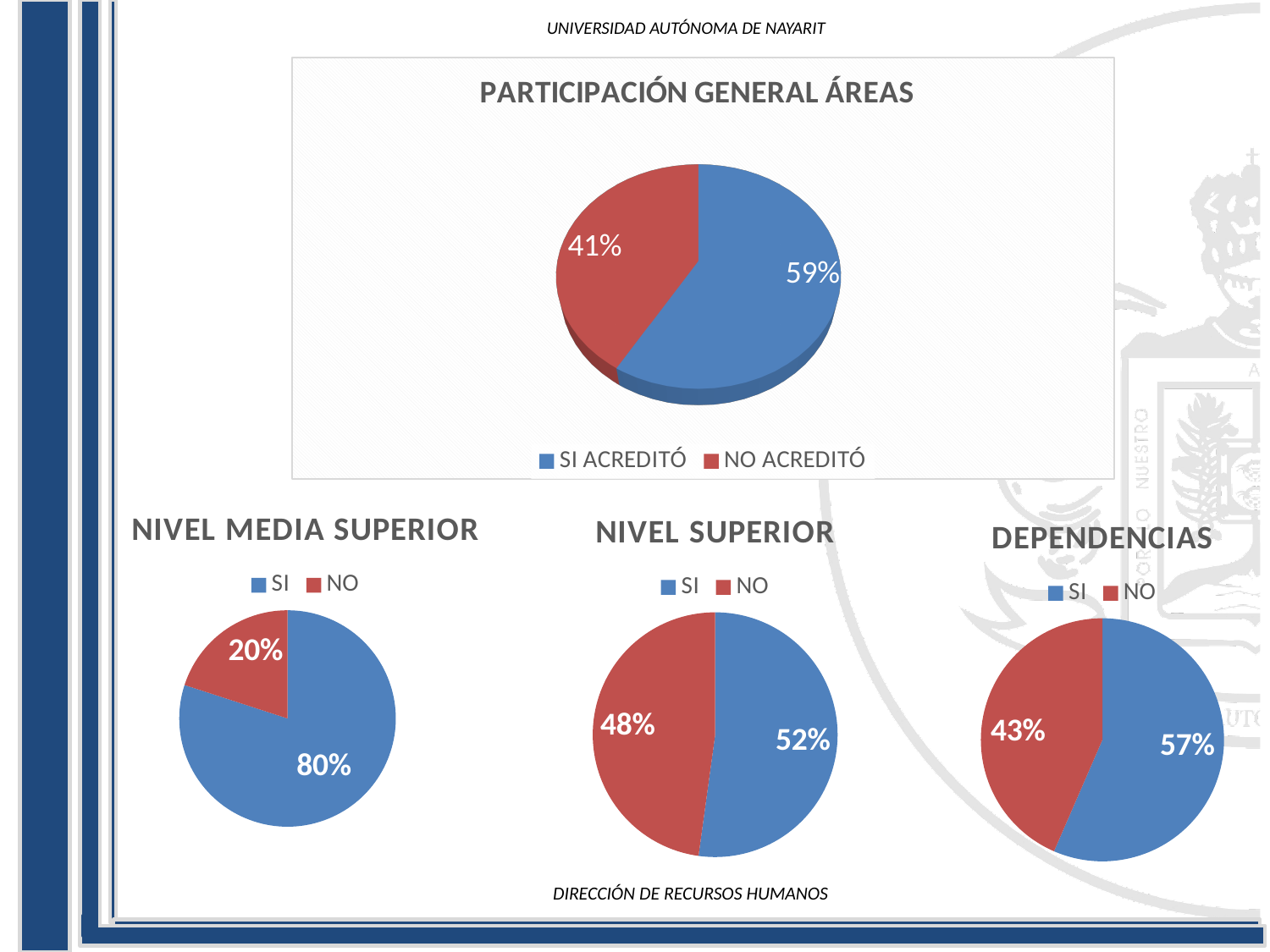
In the PARTICIPACIÓN GENERAL ÁREAS chart, what percentage is shown for SI ACREDITÓ? 59% In the NIVEL MEDIA SUPERIOR chart, what is the difference between the SI and NO percentages? 60% In the DEPENDENCIAS chart, what percentage is shown for SI? 57% In the NIVEL MEDIA SUPERIOR chart, what percentage is shown for NO? 20% In the DEPENDENCIAS chart, which slice is larger, SI or NO? SI In the PARTICIPACIÓN GENERAL ÁREAS chart, what colour is the SI ACREDITÓ slice? Blue In the NIVEL MEDIA SUPERIOR chart, what percentage is shown for SI? 80% What kind of chart is the NIVEL SUPERIOR chart? Pie chart In the PARTICIPACIÓN GENERAL ÁREAS chart, what is the difference between SI ACREDITÓ and NO ACREDITÓ? 18% How many slices does the DEPENDENCIAS chart have? 2 In the PARTICIPACIÓN GENERAL ÁREAS chart, what percentage is shown for NO ACREDITÓ? 41% In the NIVEL SUPERIOR chart, what percentage is shown for NO? 48%